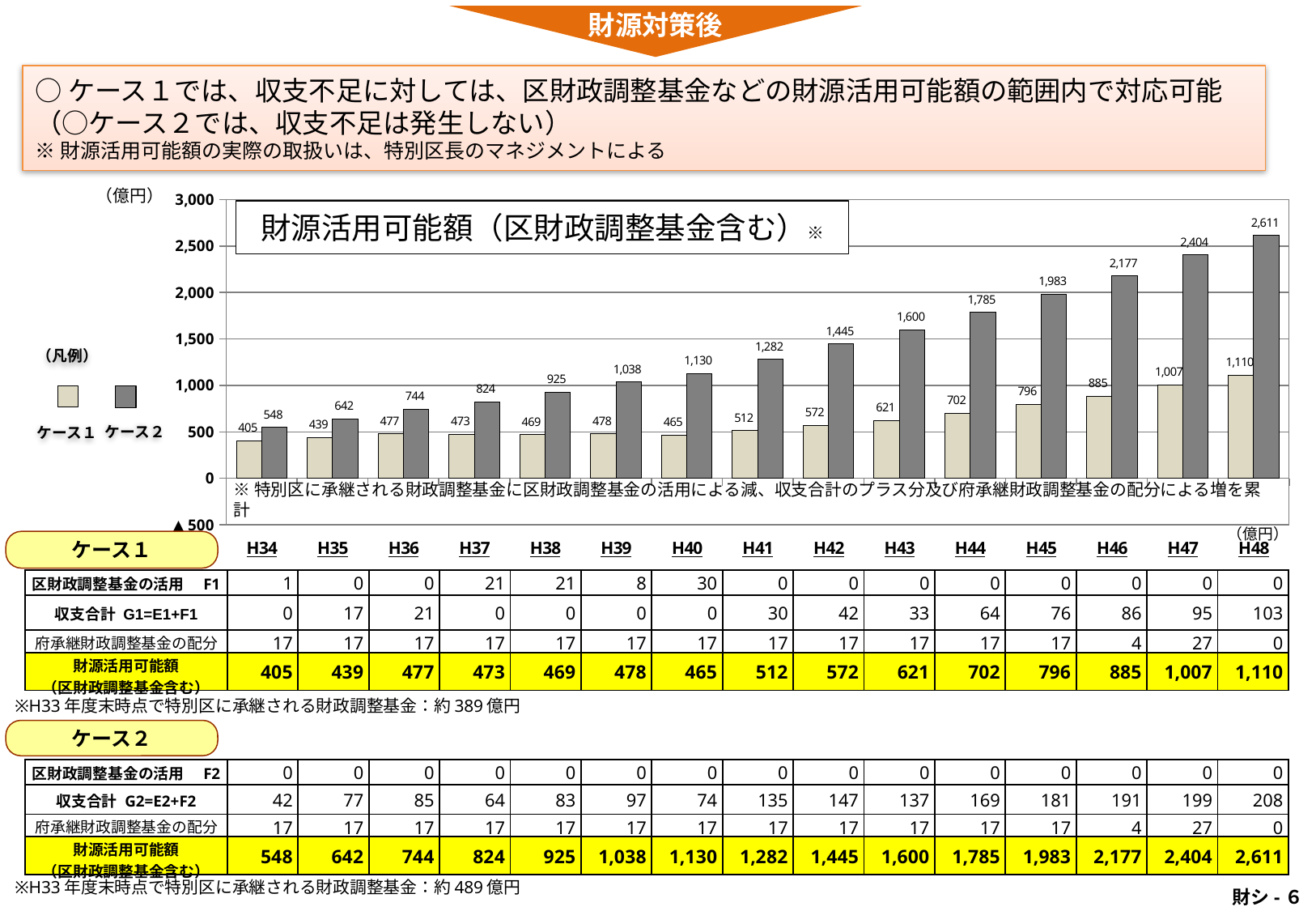
What kind of chart is shown? bar chart What is the value for ケース１ in H47? 1,007 What is the value for ケース２ in H40? 1,130 Do the ケース２ values rise or fall from H34 to H48? rise In which year is the ケース１ value lowest? H34 Which is larger in H42: the ケース１ value or the ケース２ value? ケース２ What is the difference between the ケース２ and ケース１ values in H48? 1,501 What is the value for ケース１ in H34? 405 How many series does the legend list? 2 How many years are shown on the x axis of the chart? 15 In which year is the ケース２ value highest? H48 What is the value for ケース２ in H48? 2,611